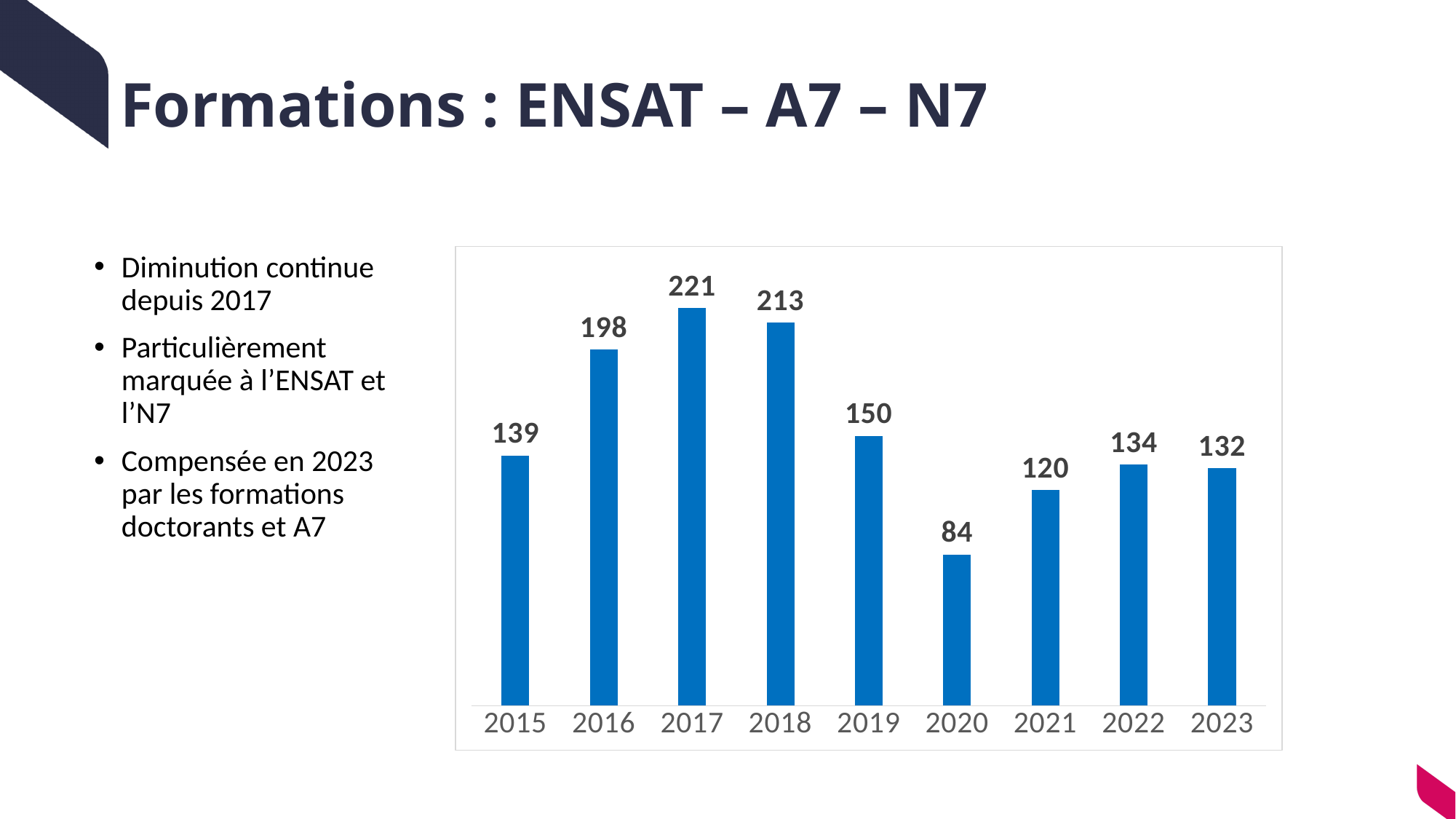
What is the difference between the values for 2019 and 2020? 66 Which year has the lowest value? 2020 What is the value for 2020? 84 What is the value for 2015? 139 Do the values rise or fall from 2017 to 2020? fall What kind of chart is shown on the slide? bar chart What is the value for 2017? 221 What is the difference between the values for 2017 and 2018? 8 What is the value for 2023? 132 Which is larger, the value for 2016 or the value for 2019? 2016 Which year has the highest value? 2017 How many years are shown on the x axis? 9